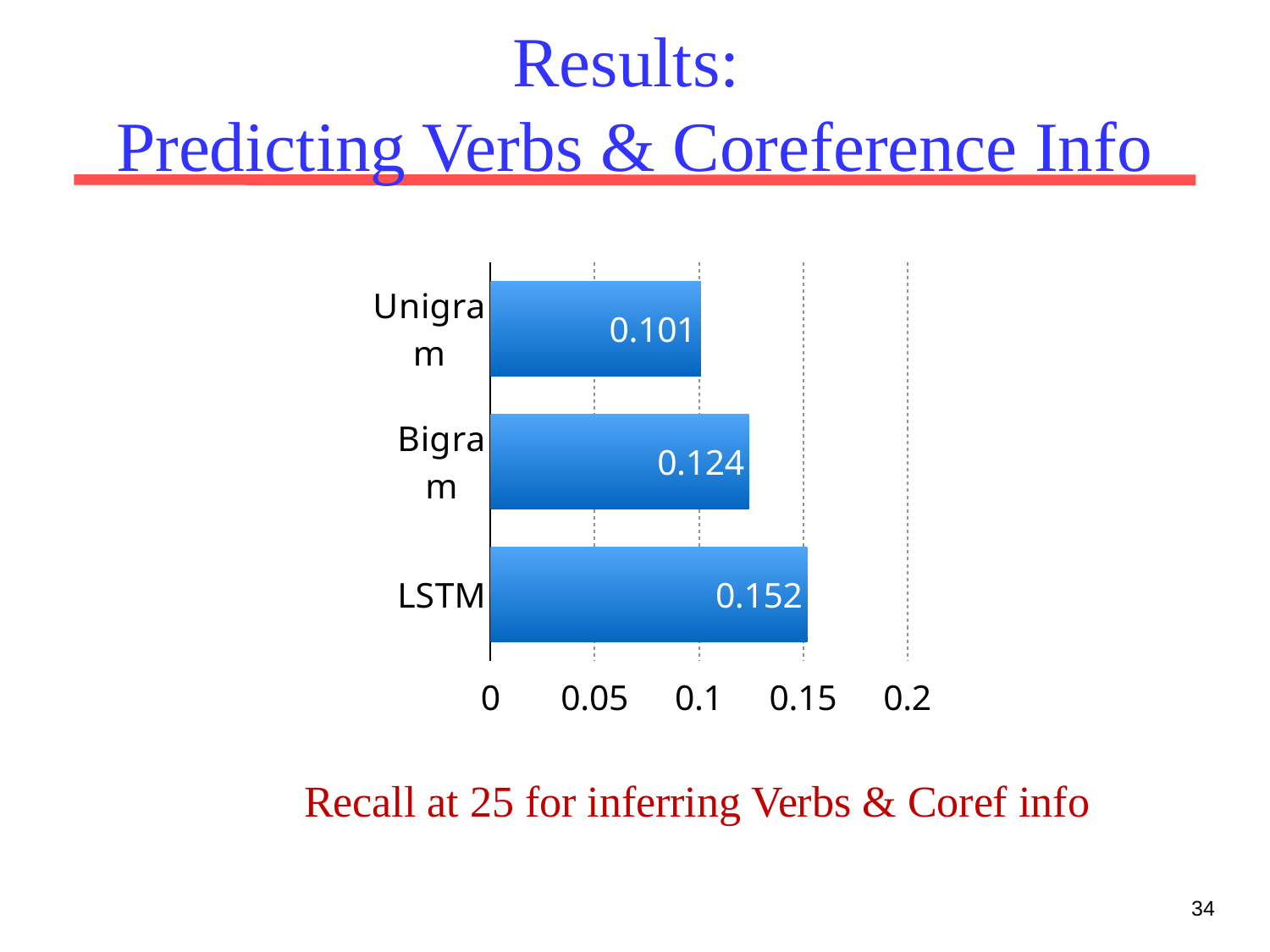
Which is larger, the value for Bigram or the value for LSTM? LSTM How many categories are shown in the chart? 3 Is the value for LSTM greater or less than 0.15? greater What is the value for LSTM? 0.152 Which category has the lowest value? Unigram What is the difference between the values for LSTM and Unigram? 0.051 What is the difference between the values for Bigram and Unigram? 0.023 What does the caption below the chart say the values represent? Recall at 25 for inferring Verbs & Coref info Which category has the highest value? LSTM What is the value for Unigram? 0.101 What is the value for Bigram? 0.124 What kind of chart is shown on the slide? bar chart